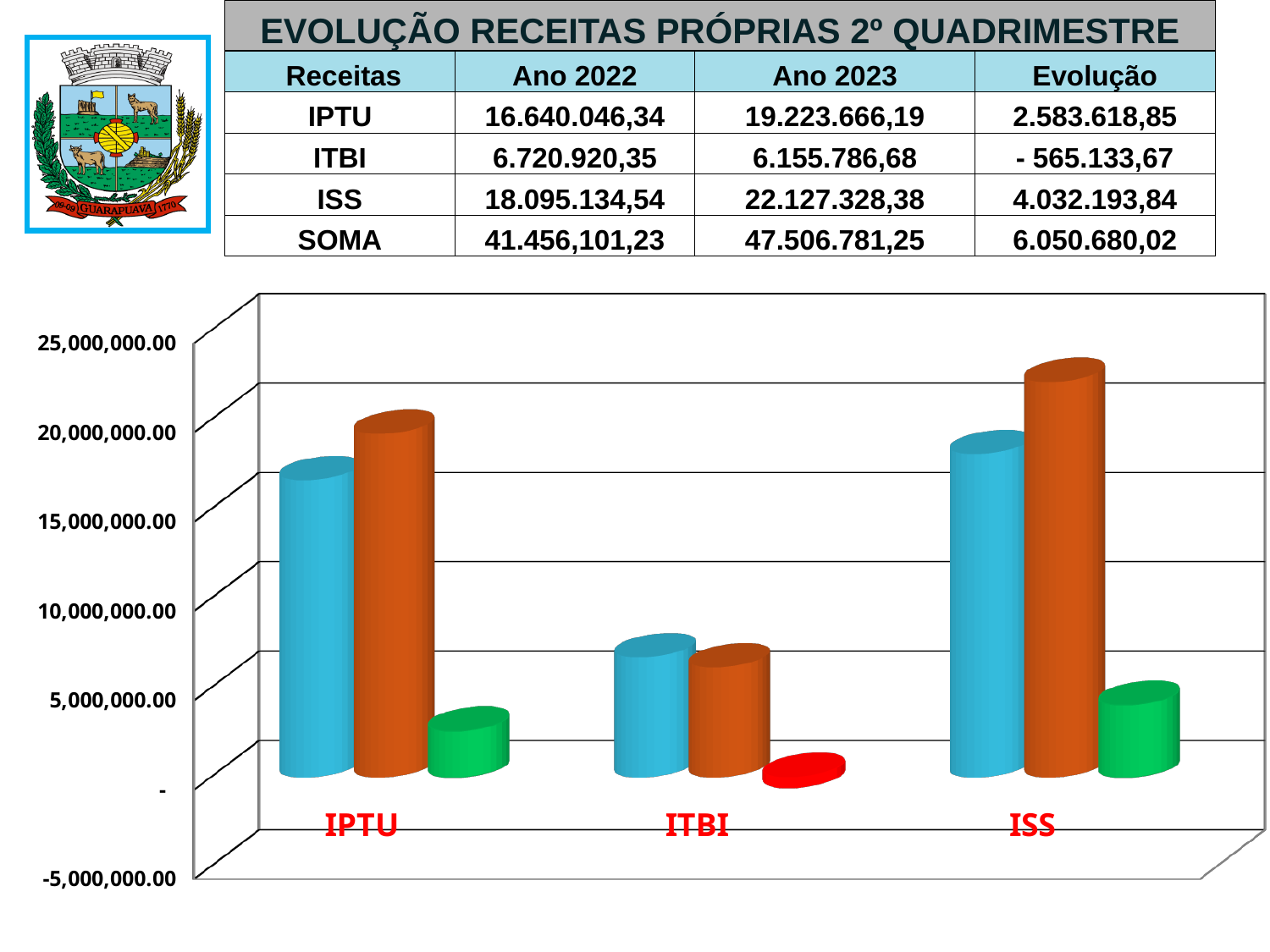
Which category on the chart has the shortest bars overall? ITBI According to the table, what is the SOMA (total) for Ano 2023? 47.506.781,25 According to the table, what is the IPTU value for Ano 2023? 19.223.666,19 Is the tallest bar for ISS greater or less than 20,000,000.00? greater According to the table, what is the Evolução value for ITBI? - 565.133,67 How many categories are shown on the x axis of the chart? 3 According to the table, what is the difference (Evolução) between Ano 2023 and Ano 2022 for ISS? 4.032.193,84 Which category on the chart has a red bar? ITBI What kind of chart is shown on the slide? bar chart Is the tallest bar for ITBI greater or less than 10,000,000.00? less Which category on the chart has the tallest bar? ISS Which is larger for Ano 2022: IPTU or ISS? ISS